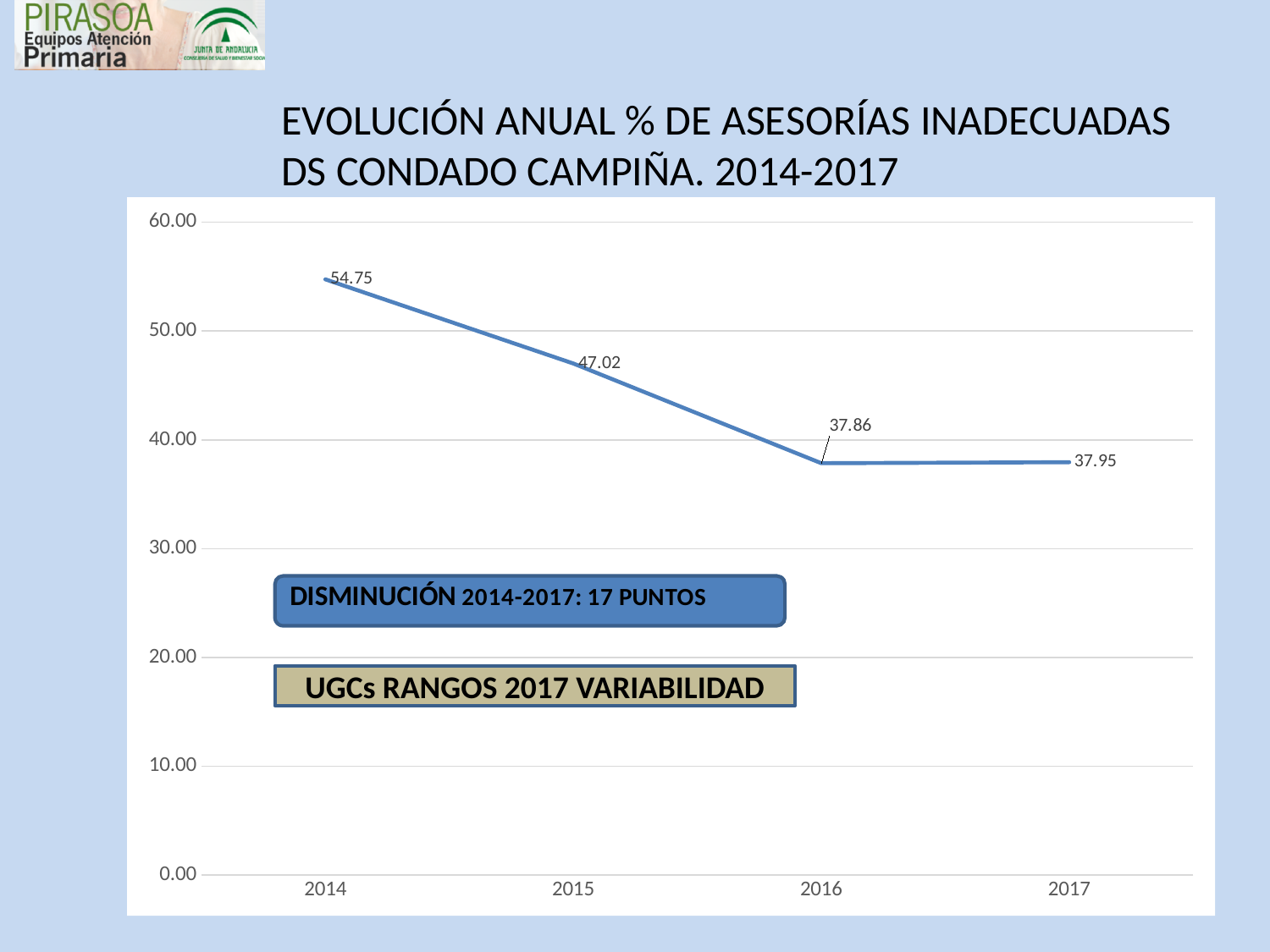
How many years are plotted on the x axis? 4 What is the value for 2014? 54.75 What kind of chart is shown on the slide? line chart What is the value for 2017? 37.95 What is the value for 2015? 47.02 Which is larger, the value for 2015 or the value for 2016? 2015 Which year has the highest value? 2014 Which year has the lowest value? 2016 What is the value for 2016? 37.86 What is the difference between the values for 2014 and 2015? 7.73 Do the values generally rise or fall from 2014 to 2017? fall What is the difference between the values for 2014 and 2017? 16.80